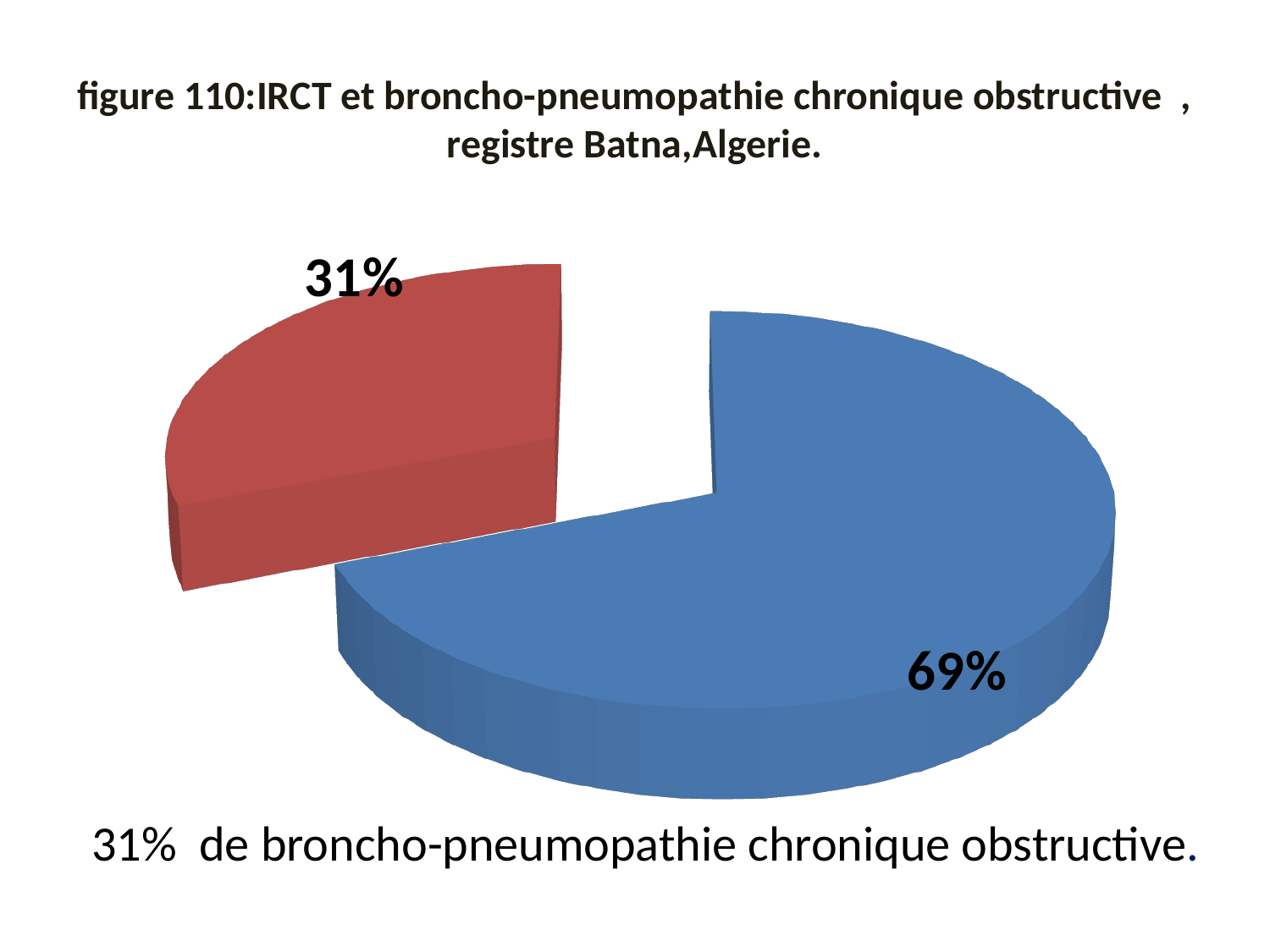
According to the text below the chart, what percentage corresponds to broncho-pneumopathie chronique obstructive? 31% How many slices does the pie chart have? 2 Which slice of the pie chart is the smallest? the red slice (31%) What is the figure number given in the chart title? figure 110 Which is larger, the red slice or the blue slice? the blue slice Which registry is named in the chart title? registre Batna, Algerie Which slice of the pie chart is the largest? the blue slice (69%) What percentage is shown on the red slice of the pie chart? 31% What is the difference in percentage points between the blue slice and the red slice? 38 What kind of chart is shown on the slide? pie chart What percentage is shown on the blue slice of the pie chart? 69% What share of the pie does the red slice represent? 31%